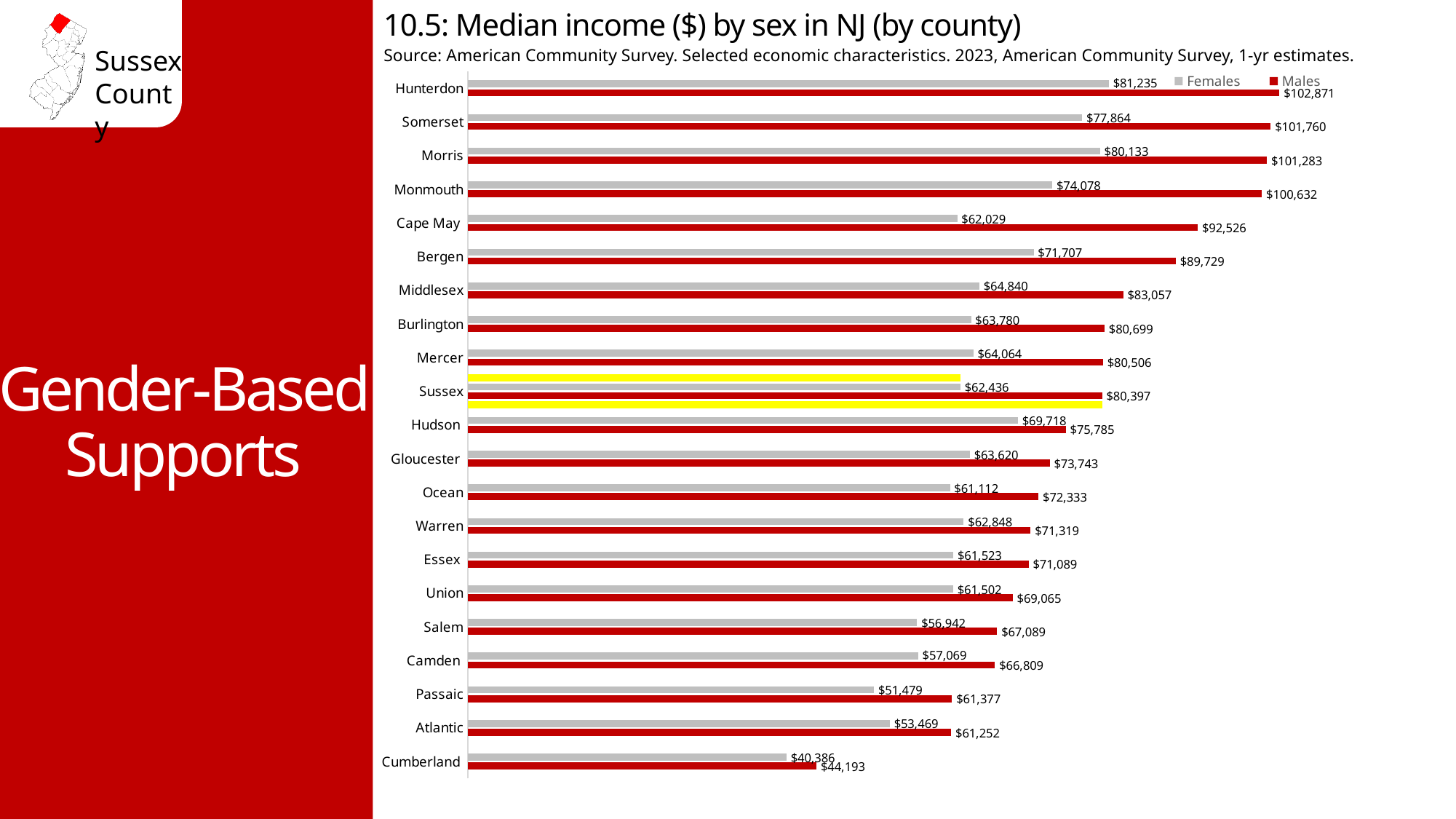
Which county has the lowest median income for females? Cumberland What is the difference between male and female median income in Sussex County? $17,961 How many counties are shown in the chart? 21 Which county has the highest median income for males? Hunterdon What is the median income for males in Hunterdon County? $102,871 How many series does the legend list? 2 Which is larger, the female median income in Hudson County or in Bergen County? Bergen County What is the median income for males in Sussex County? $80,397 What is the median income for females in Cumberland County? $40,386 What is the median income for females in Sussex County? $62,436 What kind of chart is shown on the slide? Bar chart What is the difference between male and female median income in Cumberland County? $3,807